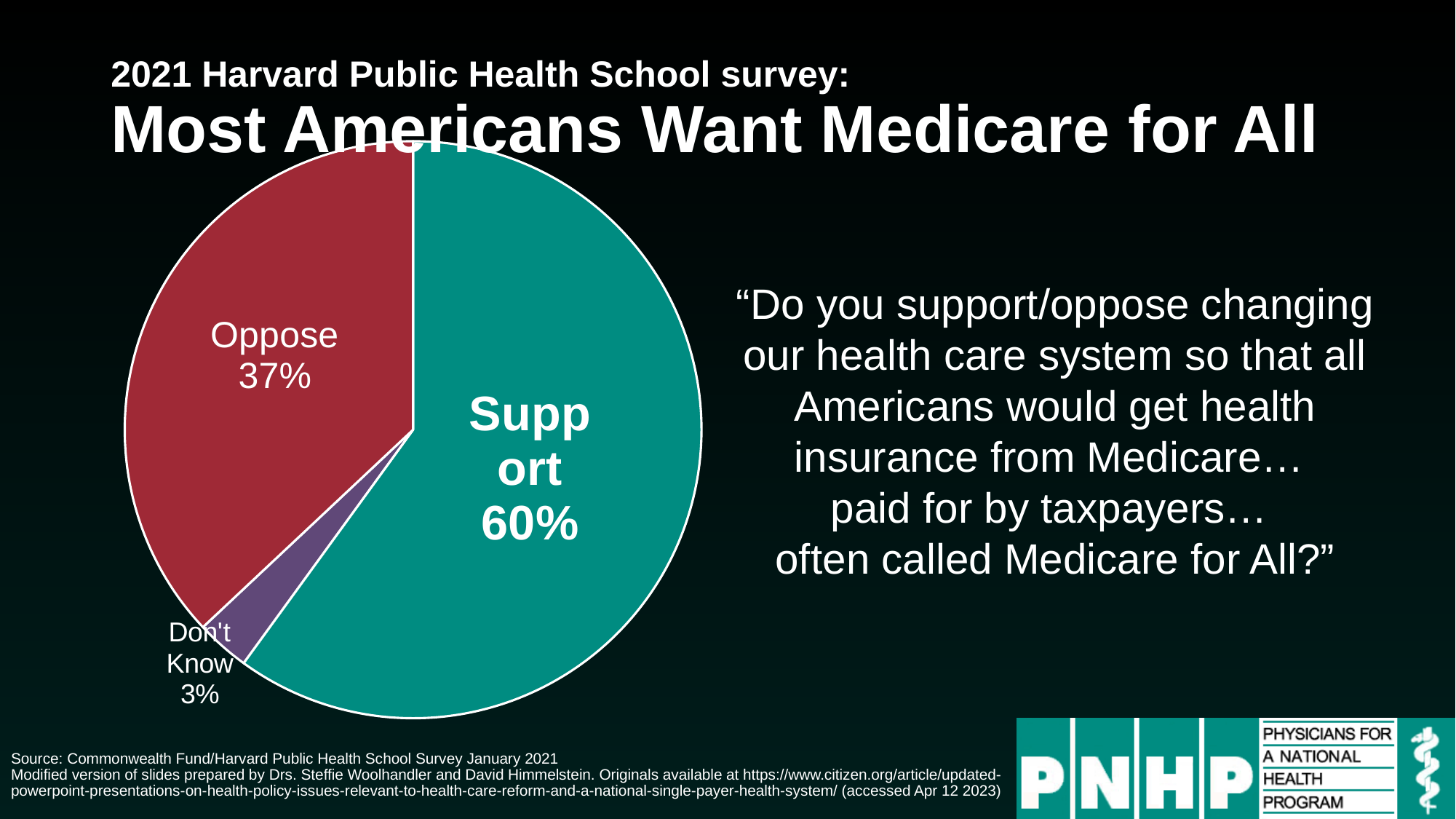
How many slices does the pie chart have? 3 What is the combined percentage of Oppose and Don't Know? 40% Which response has the largest share of the pie? Support Which response has the smallest share of the pie? Don't Know What kind of chart is shown on the slide? Pie chart What is the difference in percentage points between Support and Oppose? 23 What colour is the Oppose slice? Red Which is larger, the Oppose share or the Don't Know share? Oppose What percentage of respondents support Medicare for All? 60% What percentage of respondents answered Don't Know? 3% What percentage of respondents oppose Medicare for All? 37% What colour is the Support slice? Teal